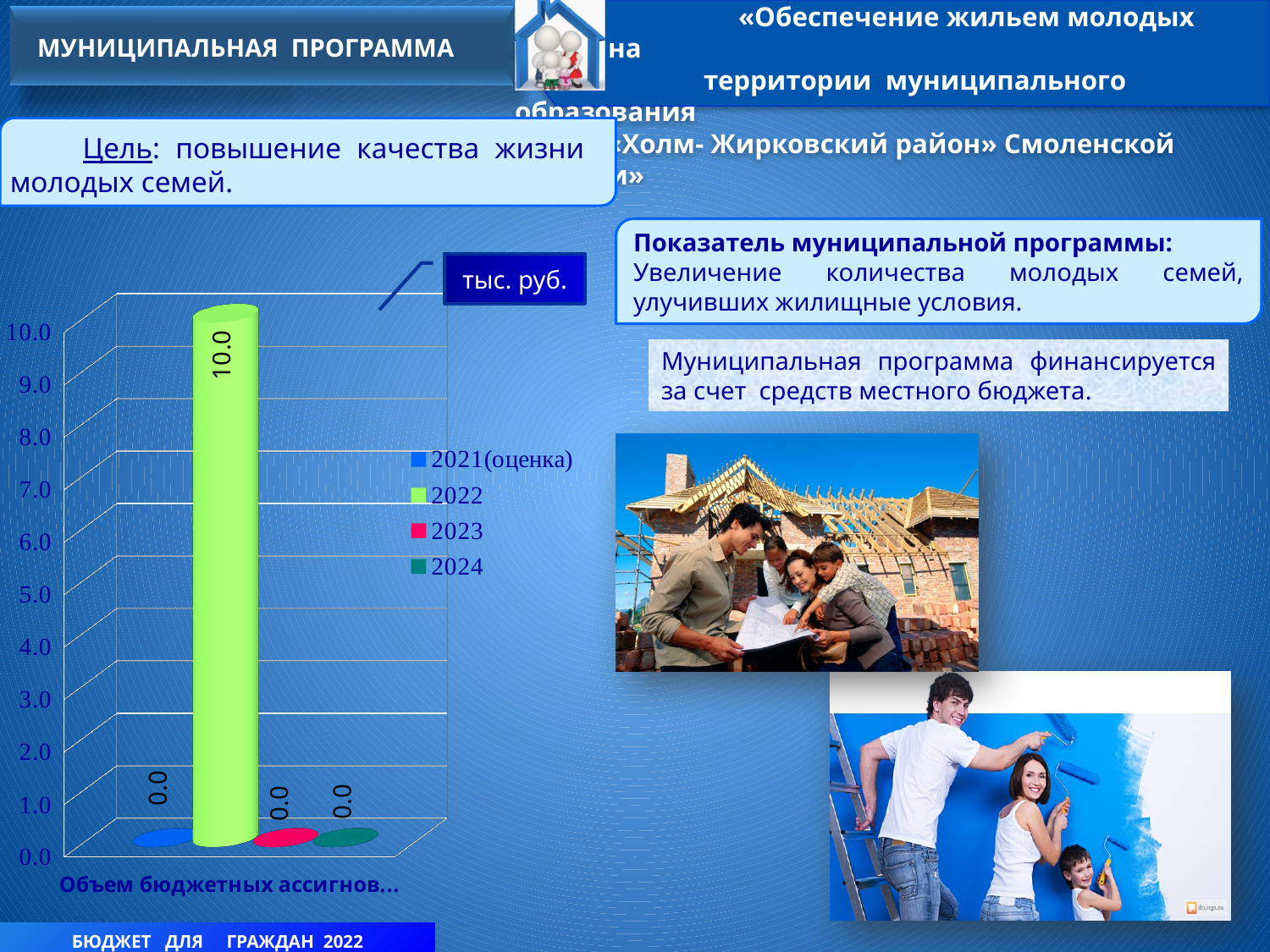
Is the value for 2022 greater or less than 5.0? greater What is the value for 2022 in the chart? 10.0 What kind of chart is shown on the slide? bar chart How many series does the chart legend list? 4 Which series has the highest value in the chart? 2022 What is the difference between the values for 2022 and 2023? 10.0 Which is larger, the value for 2022 or the value for 2021(оценка)? 2022 What is the value for 2024 in the chart? 0.0 What unit of measurement is indicated for the chart values? тыс. руб. What colour is the bar for 2022 in the chart? green What is the value for 2023 in the chart? 0.0 What is the value for 2021(оценка) in the chart? 0.0